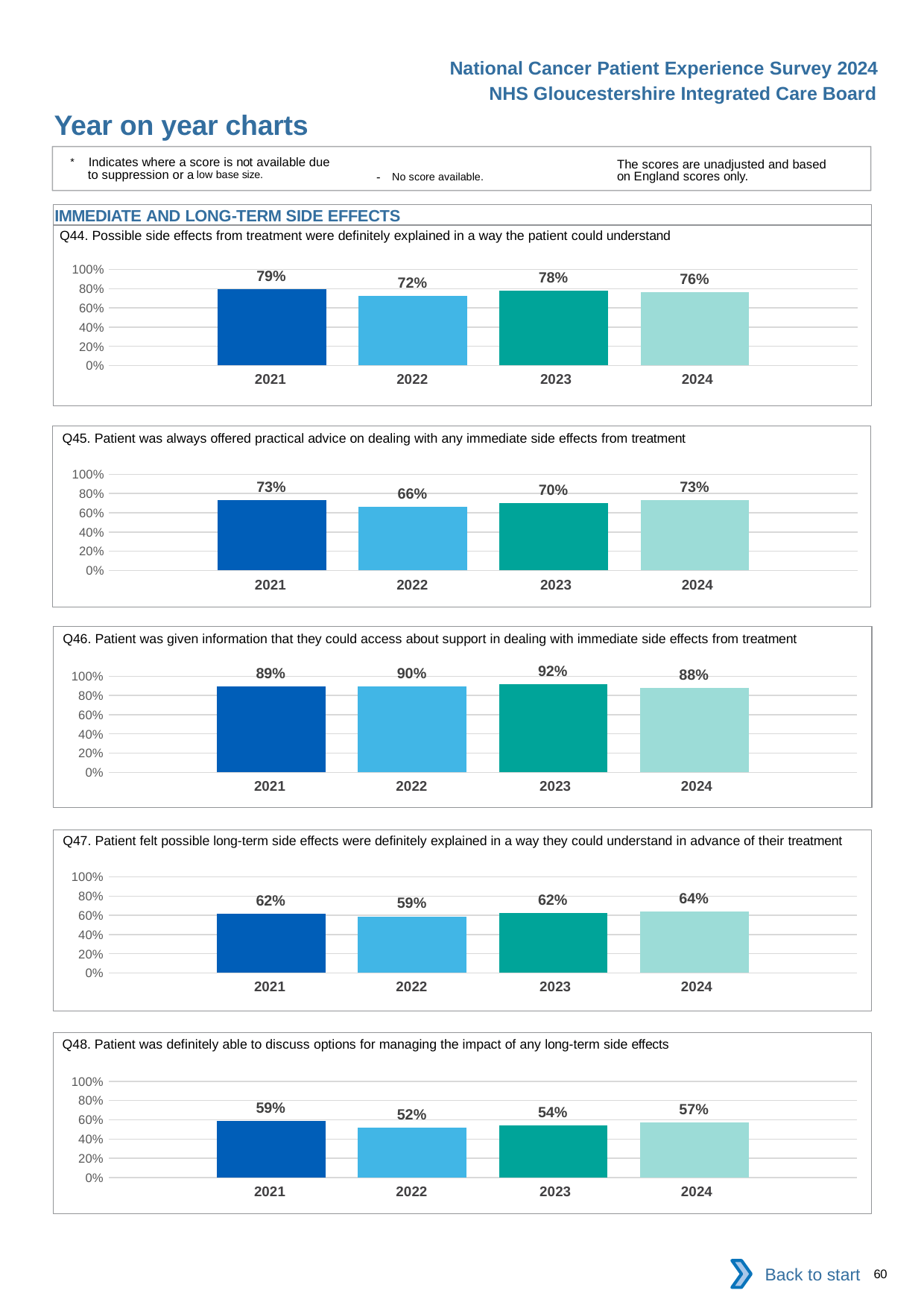
In the Q44 chart, what is the value for 2021? 79% In the Q46 chart, what is the value for 2024? 88% In the Q48 chart, what is the difference between the 2021 and 2022 values? 7 percentage points What type of chart is used for Q44? Bar chart In the Q45 chart, what is the difference between the 2021 and 2022 values? 7 percentage points In the Q48 chart, how many years are shown on the x axis? 4 In the Q48 chart, is the value for 2022 greater or less than 60%? less In the Q45 chart, what is the value for 2024? 73% In the Q47 chart, which is larger, the value for 2022 or the value for 2024? 2024 In the Q46 chart, which year has the highest value? 2023 In the Q44 chart, which year has the lowest value? 2022 In the Q47 chart, what is the value for 2023? 62%